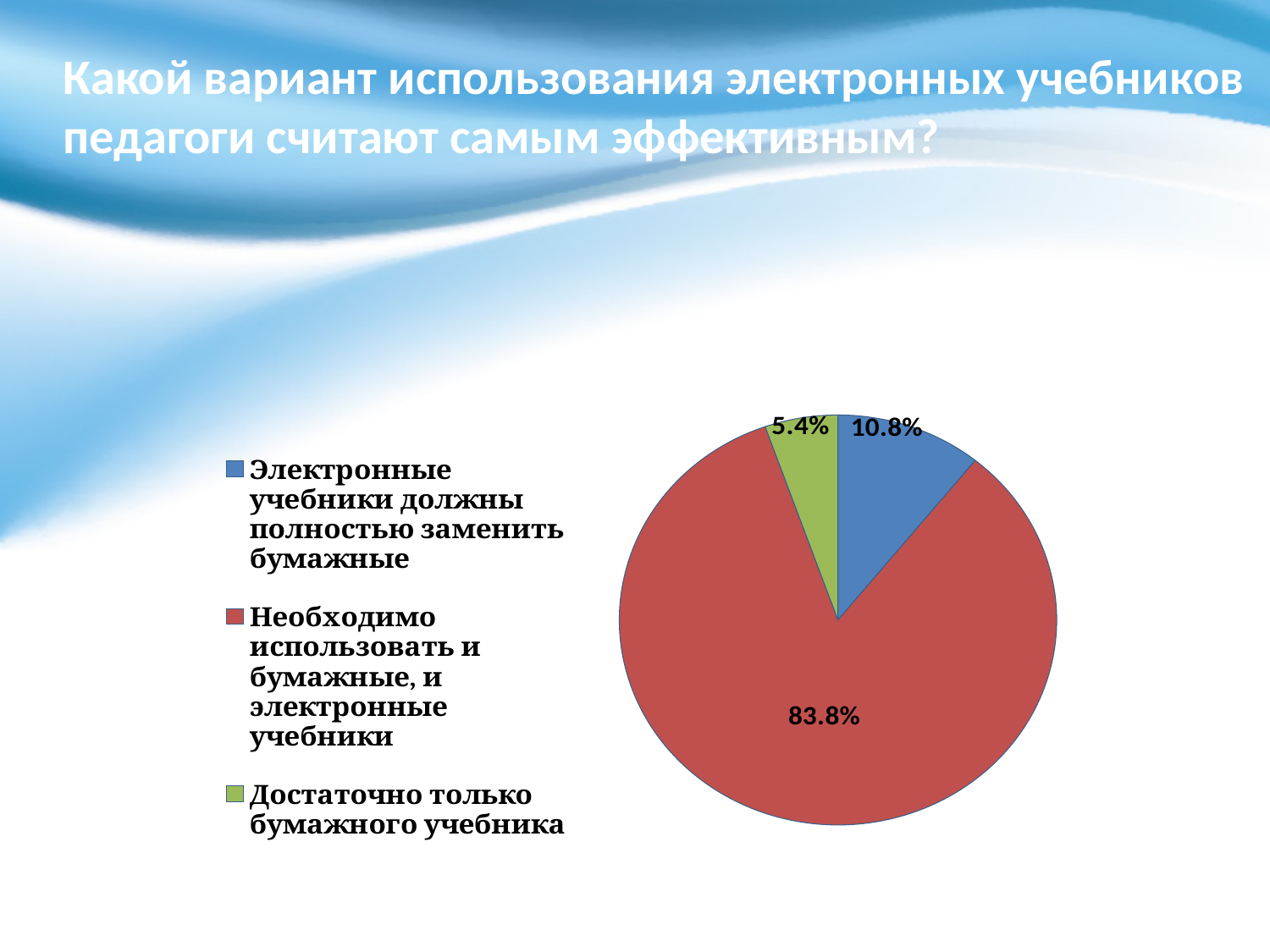
How many categories does the pie chart show? 3 What kind of chart is shown on the slide? pie chart What share of the pie is labelled for "Электронные учебники должны полностью заменить бумажные"? 10.8% Which category has the smallest slice of the pie? Достаточно только бумажного учебника What colour is the slice for "Достаточно только бумажного учебника"? green What is the combined share of the two smaller slices, 10.8% and 5.4%? 16.2% What share of the pie is labelled for "Необходимо использовать и бумажные, и электронные учебники"? 83.8% What share of the pie is labelled for "Достаточно только бумажного учебника"? 5.4% Which is larger: the slice for "Электронные учебники должны полностью заменить бумажные" or the slice for "Достаточно только бумажного учебника"? Электронные учебники должны полностью заменить бумажные What is the difference in percentage points between the largest slice (83.8%) and the slice for "Электронные учебники должны полностью заменить бумажные" (10.8%)? 73.0 percentage points What colour is the slice for "Необходимо использовать и бумажные, и электронные учебники"? red Which category has the largest slice of the pie? Необходимо использовать и бумажные, и электронные учебники